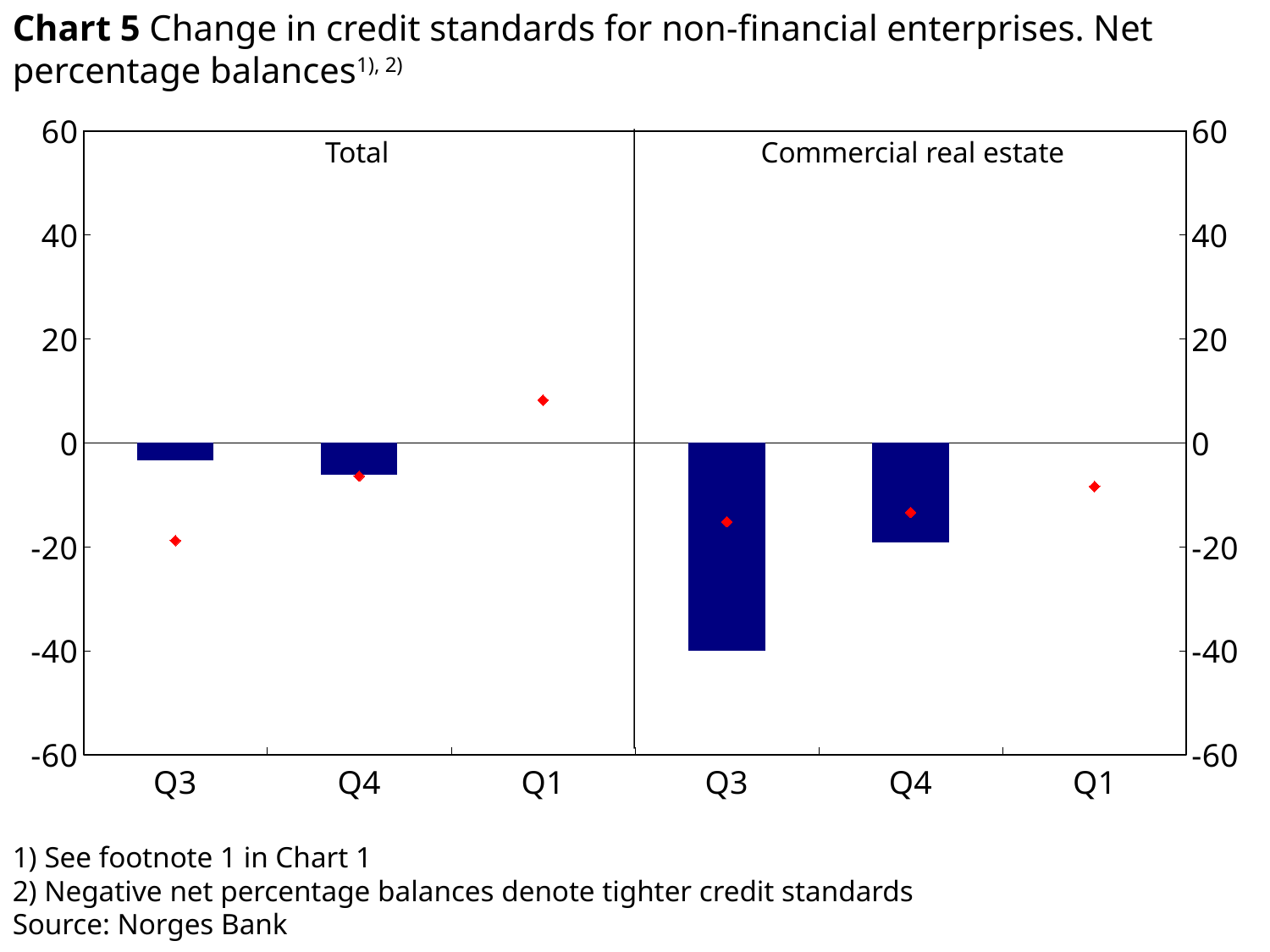
What is the source given for the chart? Norges Bank Is the red marker for Q1 in the Commercial real estate panel greater or less than 0? less In the Commercial real estate panel, do the bars rise or fall from Q3 to Q4? rise Is the Q3 bar in the Total panel greater or less than -20? greater What are the two panels of the chart labelled? Total and Commercial real estate What kind of chart is shown on the slide? combination bar and line chart (bars with red diamond markers) Which bar in the chart is the lowest? Q3 in Commercial real estate How many quarter categories are shown across both panels of the chart? 6 Is the Q3 bar in the Commercial real estate panel greater or less than -20? less Which is lower, the Q3 bar in the Total panel or the Q3 bar in the Commercial real estate panel? Q3 in Commercial real estate What is the value of the Q3 bar in the Commercial real estate panel? -40